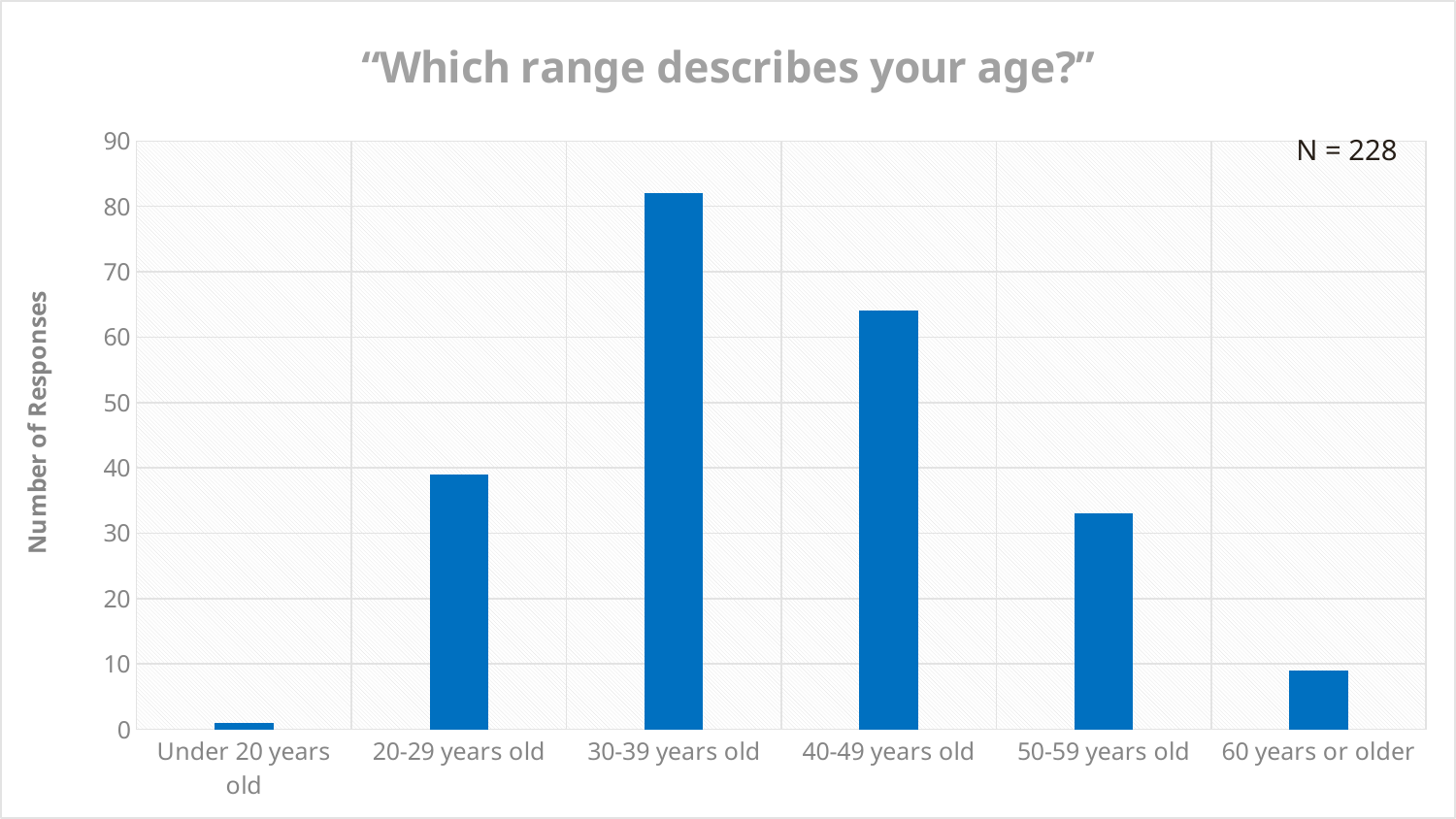
Is the value for 30-39 years old greater or less than 80? greater Is the value for 40-49 years old greater or less than 60? greater Is the value for 50-59 years old greater or less than 30? greater What type of chart is shown on the slide? bar chart Which age range has the highest number of responses? 30-39 years old How many age range categories are shown on the x axis? 6 What is the title of the chart? "Which range describes your age?" What sample size (N) is noted on the chart? N = 228 Which age range has the lowest number of responses? Under 20 years old Which has more responses, 20-29 years old or 50-59 years old? 20-29 years old